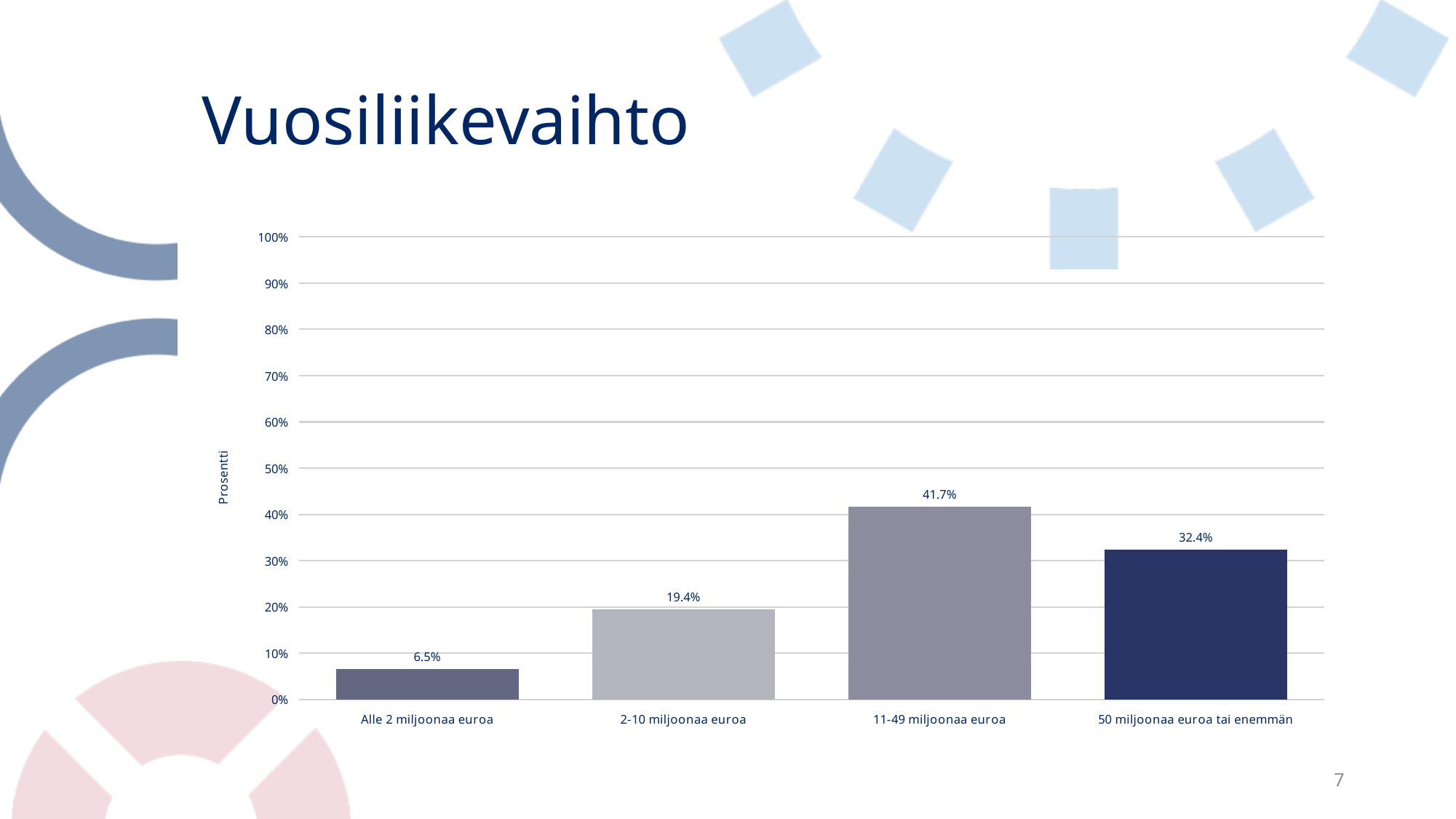
Which category has the lowest value? Alle 2 miljoonaa euroa What is the value for "Alle 2 miljoonaa euroa"? 6.5% Which is larger: the value for "2-10 miljoonaa euroa" or the value for "50 miljoonaa euroa tai enemmän"? 50 miljoonaa euroa tai enemmän Is the value for "11-49 miljoonaa euroa" greater or less than 50%? less What is the value for "2-10 miljoonaa euroa"? 19.4% How many categories are shown on the x axis? 4 Which category has the highest value? 11-49 miljoonaa euroa What is the value for "11-49 miljoonaa euroa"? 41.7% What is the label of the vertical axis? Prosentti What is the value for "50 miljoonaa euroa tai enemmän"? 32.4% What is the difference between the values for "11-49 miljoonaa euroa" and "50 miljoonaa euroa tai enemmän"? 9.3% What kind of chart is shown on the slide? bar chart